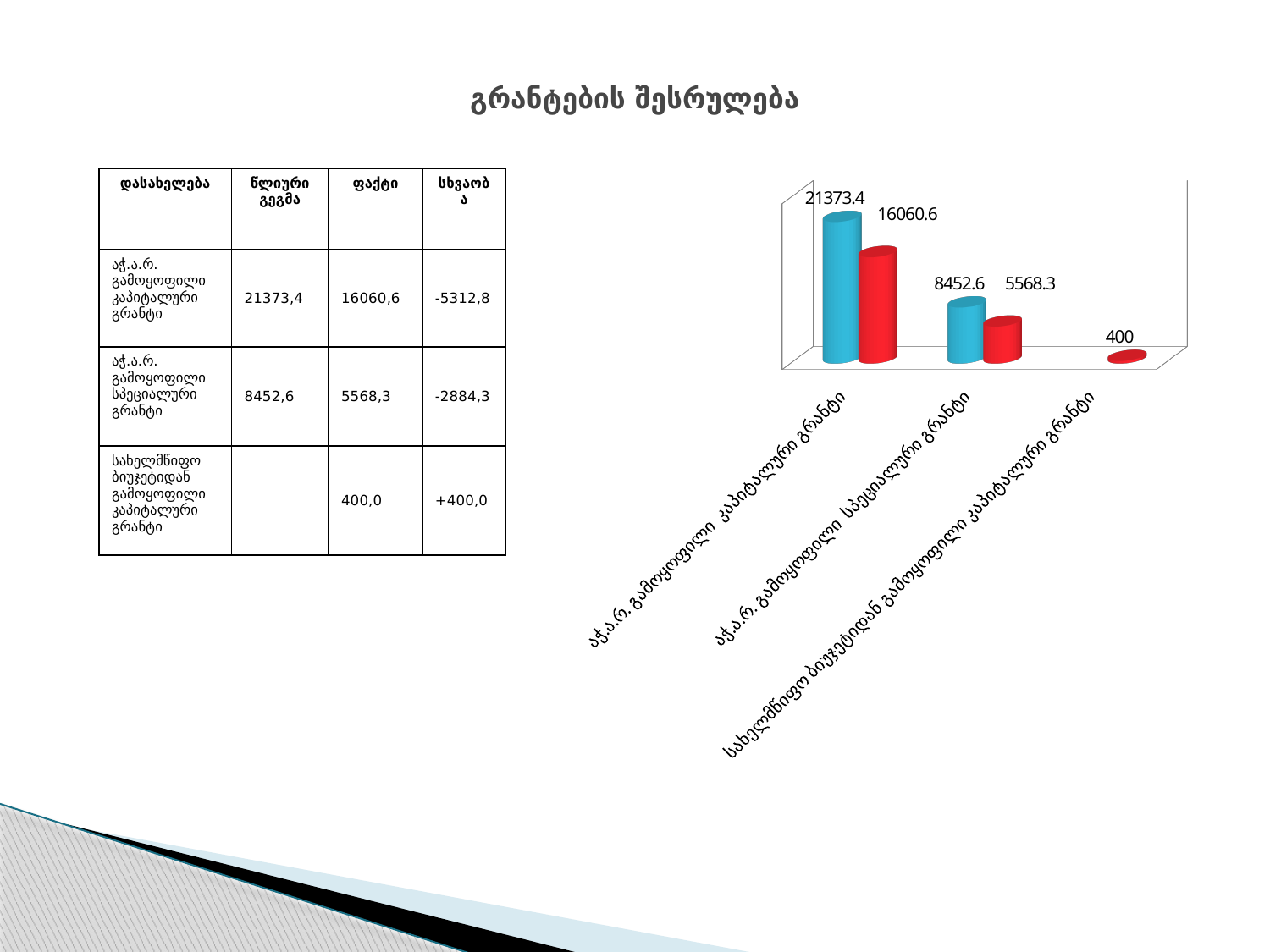
Which category has the tallest bar on the chart? აჭ.ა.რ. გამოყოფილი კაპიტალური გრანტი How many categories are shown on the chart's x axis? 3 What is the value of the blue bar for აჭ.ა.რ. გამოყოფილი კაპიტალური გრანტი on the chart? 21373.4 On the chart, what is the difference between the blue bar and the red bar for აჭ.ა.რ. გამოყოფილი სპეციალური გრანტი? 2884.3 What is the smallest value labelled on the chart? 400 What is the value of the red bar for აჭ.ა.რ. გამოყოფილი კაპიტალური გრანტი on the chart? 16060.6 What is the value of the blue bar for აჭ.ა.რ. გამოყოფილი სპეციალური გრანტი on the chart? 8452.6 On the chart, what is the difference between the blue bar and the red bar for აჭ.ა.რ. გამოყოფილი კაპიტალური გრანტი? 5312.8 What kind of chart is shown on the slide? bar chart For აჭ.ა.რ. გამოყოფილი სპეციალური გრანტი, which bar is larger on the chart, the blue one or the red one? the blue one What is the value of the red bar for აჭ.ა.რ. გამოყოფილი სპეციალური გრანტი on the chart? 5568.3 What value is labelled for სახელმწიფო ბიუჯეტიდან გამოყოფილი კაპიტალური გრანტი on the chart? 400